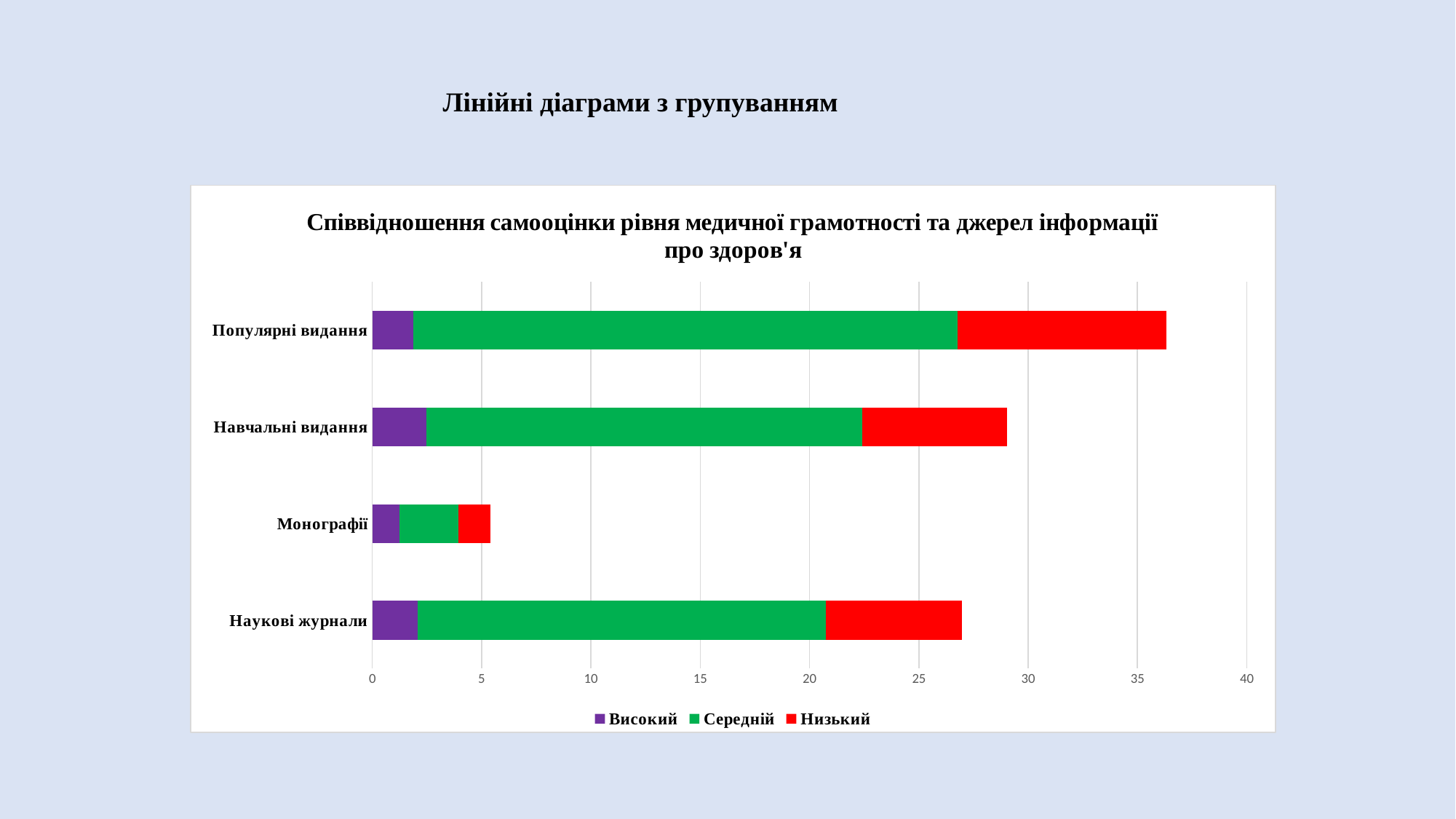
Which category has the shortest total bar? Монографії Is the total bar for Популярні видання greater or less than 35? greater Which series is shown in green in the legend? Середній How many series does the legend list? 3 Is the total bar for Наукові журнали greater or less than 25? greater How many categories (information sources) are shown on the chart? 4 What kind of chart is shown on the slide? Stacked bar chart Which has the longer total bar, Навчальні видання or Наукові журнали? Навчальні видання What are the three legend entries of the chart? Високий, Середній, Низький Which category has the longest total bar? Популярні видання Is the total bar for Навчальні видання greater or less than 30? less